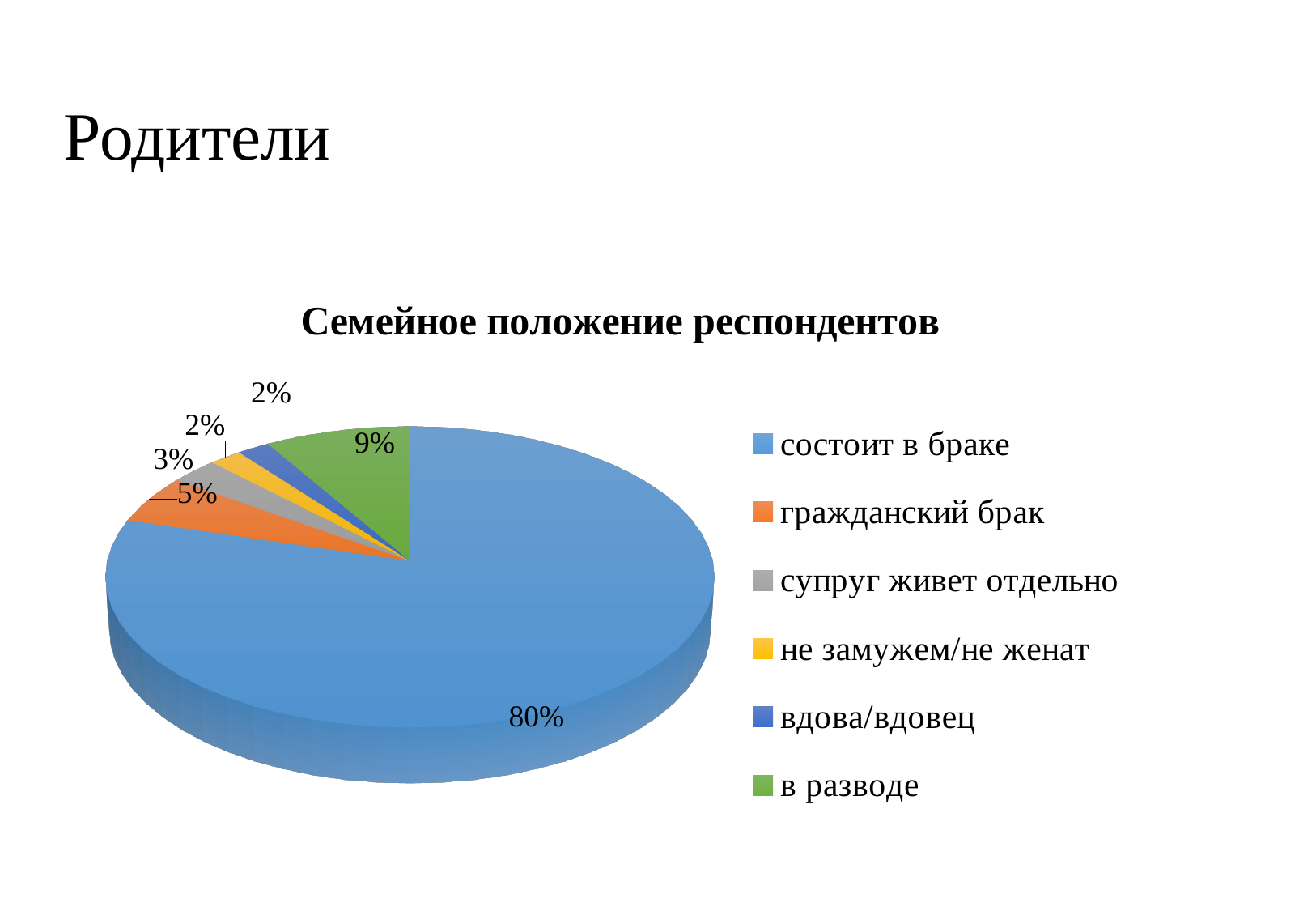
What is the difference between the share for "состоит в браке" and the share for "в разводе"? 71% What colour is the slice for "в разводе"? green How many categories does the legend list? 6 What is the title of the chart? Семейное положение респондентов What kind of chart is shown on the slide? pie chart Which is larger, the share for "в разводе" or the share for "гражданский брак"? в разводе What share of respondents is "в разводе"? 9% Which category has the largest slice of the pie? состоит в браке What share of respondents is "состоит в браке"? 80% What share of respondents is "супруг живет отдельно"? 3% What share of respondents is "гражданский брак"? 5% What share of respondents is "вдова/вдовец"? 2%